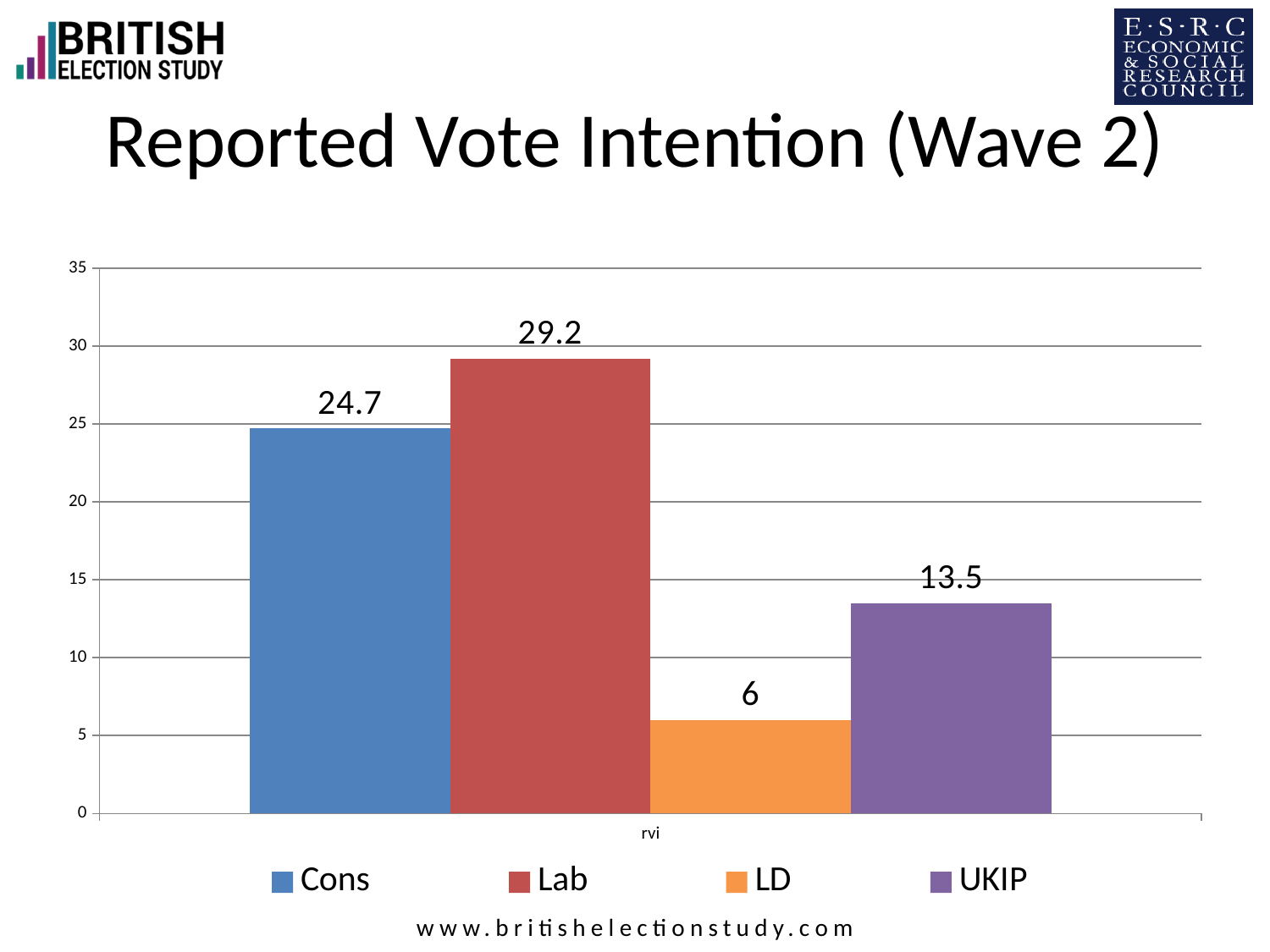
What is the reported vote intention value for Lab? 29.2 Which party has the lowest reported vote intention? LD What is the reported vote intention value for UKIP? 13.5 What kind of chart is shown on the slide? Bar chart What is the difference between the values for Lab and Cons? 4.5 What is the reported vote intention value for LD? 6 What is the difference between the values for UKIP and LD? 7.5 Which is larger, the value for Cons or the value for UKIP? Cons What is the reported vote intention value for Cons? 24.7 What is the title of the chart? Reported Vote Intention (Wave 2) Which party has the highest reported vote intention? Lab How many series does the legend list? 4